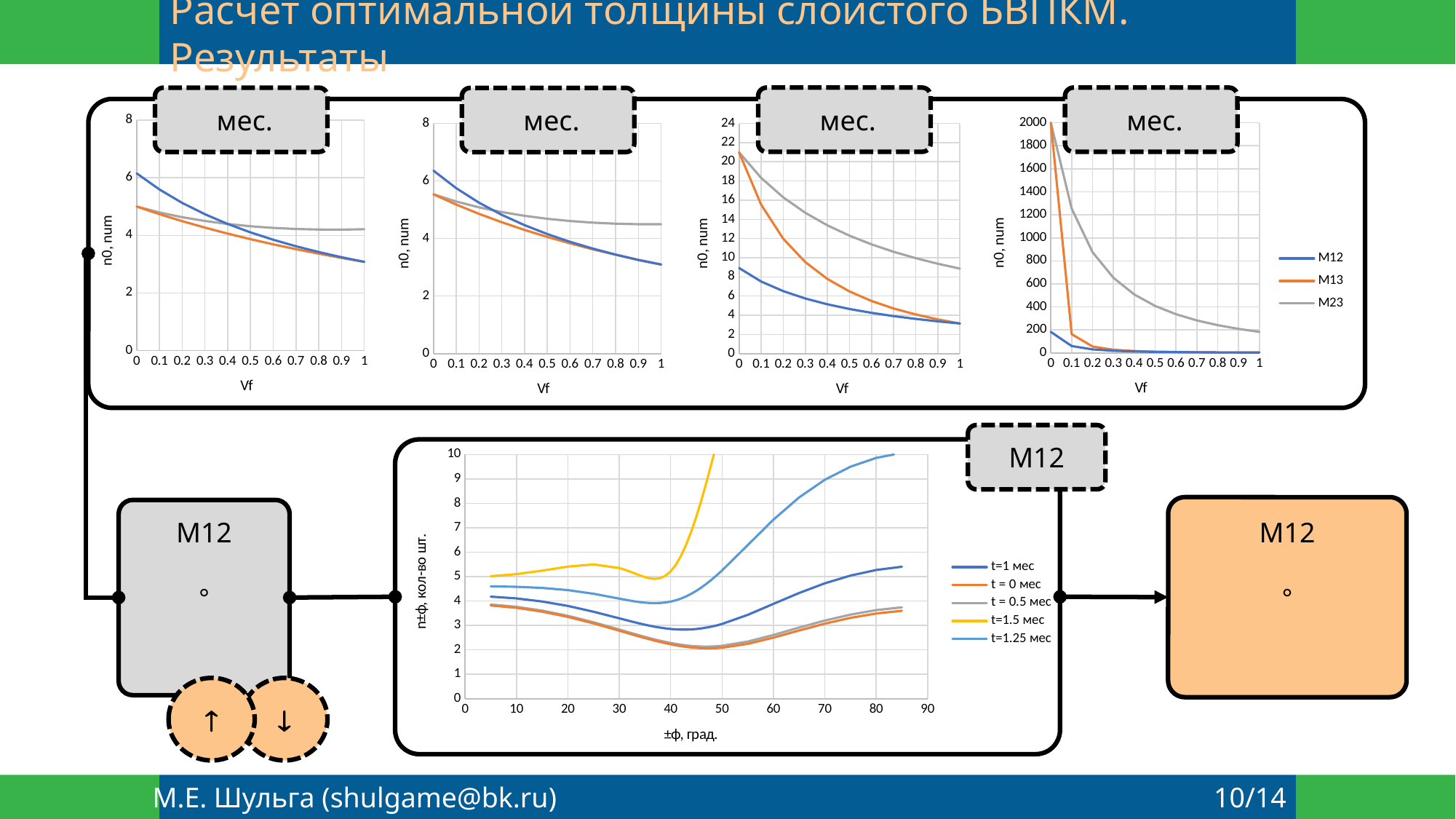
In the bottom chart, at ±φ = 80, which series has the larger value: t=1.25 мес or t=1 мес? t=1.25 мес In the third chart of the top row, does the M13 line rise or fall as Vf increases? fall In the rightmost chart of the top row, does the M12 line rise or fall as Vf increases? fall How many series does the legend of the rightmost chart in the top row list? 3 What is the y-axis label of the leftmost chart in the top row? n0, num What is the x-axis label of the bottom chart? ±φ, град. What kind of chart is the large chart at the bottom of the slide? line chart How many series does the legend of the bottom chart list? 5 In the third chart of the top row, is the value of M13 at Vf = 0 greater or less than 16? greater In the bottom chart, is the value of t=1.5 мес at ±φ = 45 greater or less than 6? greater In the leftmost chart of the top row, is the value of the blue line at Vf = 0 greater or less than 4? greater